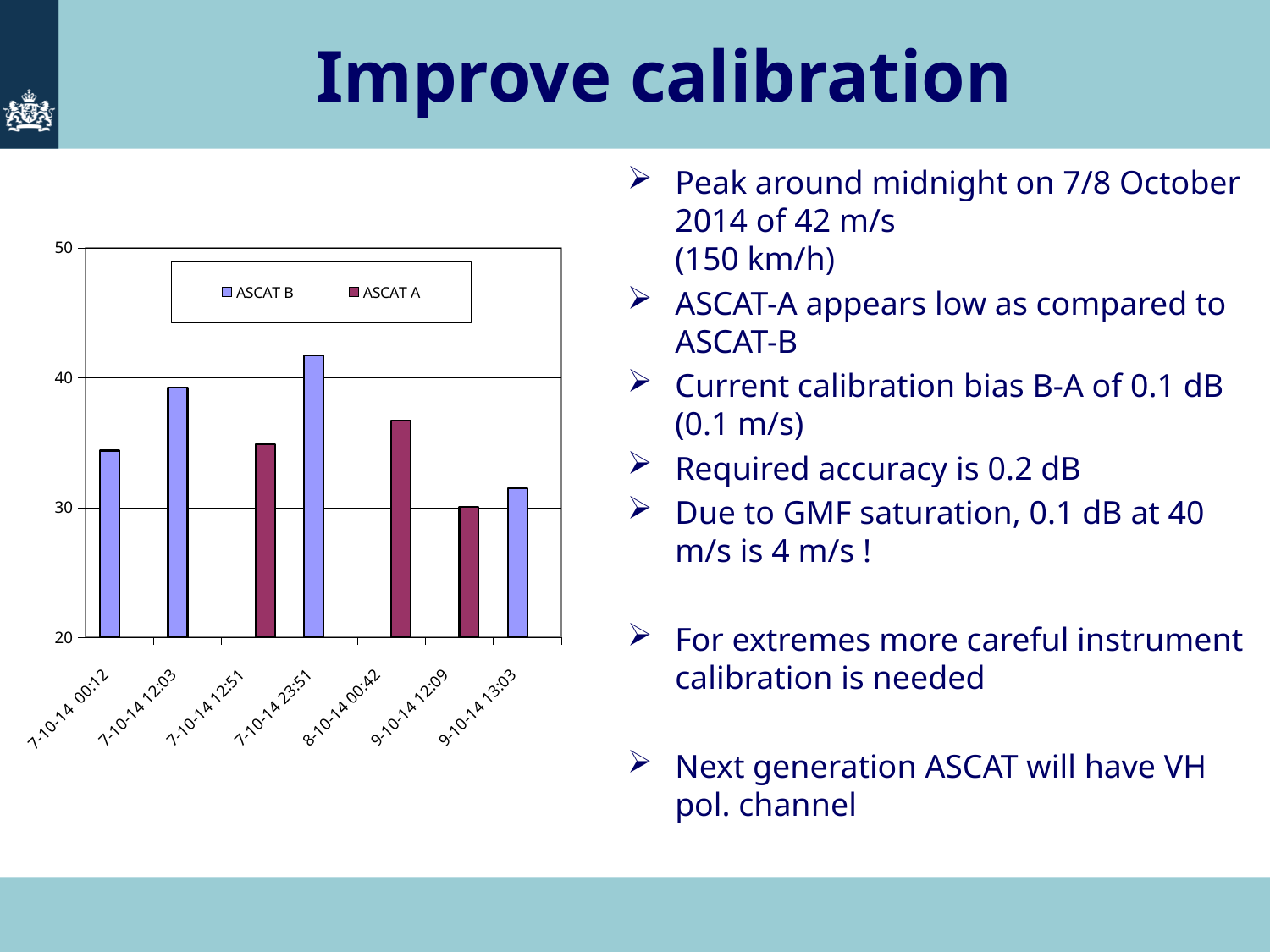
What colour are the ASCAT A bars in the chart? dark red Which series does the legend list first? ASCAT B Is the value for 7-10-14 23:51 greater or less than 40? greater How many categories are shown on the x axis of the chart? 7 Is the value for 8-10-14 00:42 greater or less than 40? less Which category has the highest bar in the chart? 7-10-14 23:51 Is the value for 9-10-14 13:03 greater or less than 30? greater What kind of chart is shown on the slide? bar chart How many series does the legend list? 2 Which category has the lowest bar in the chart? 9-10-14 12:09 Which is larger, the value for 7-10-14 12:03 or the value for 7-10-14 12:51? 7-10-14 12:03